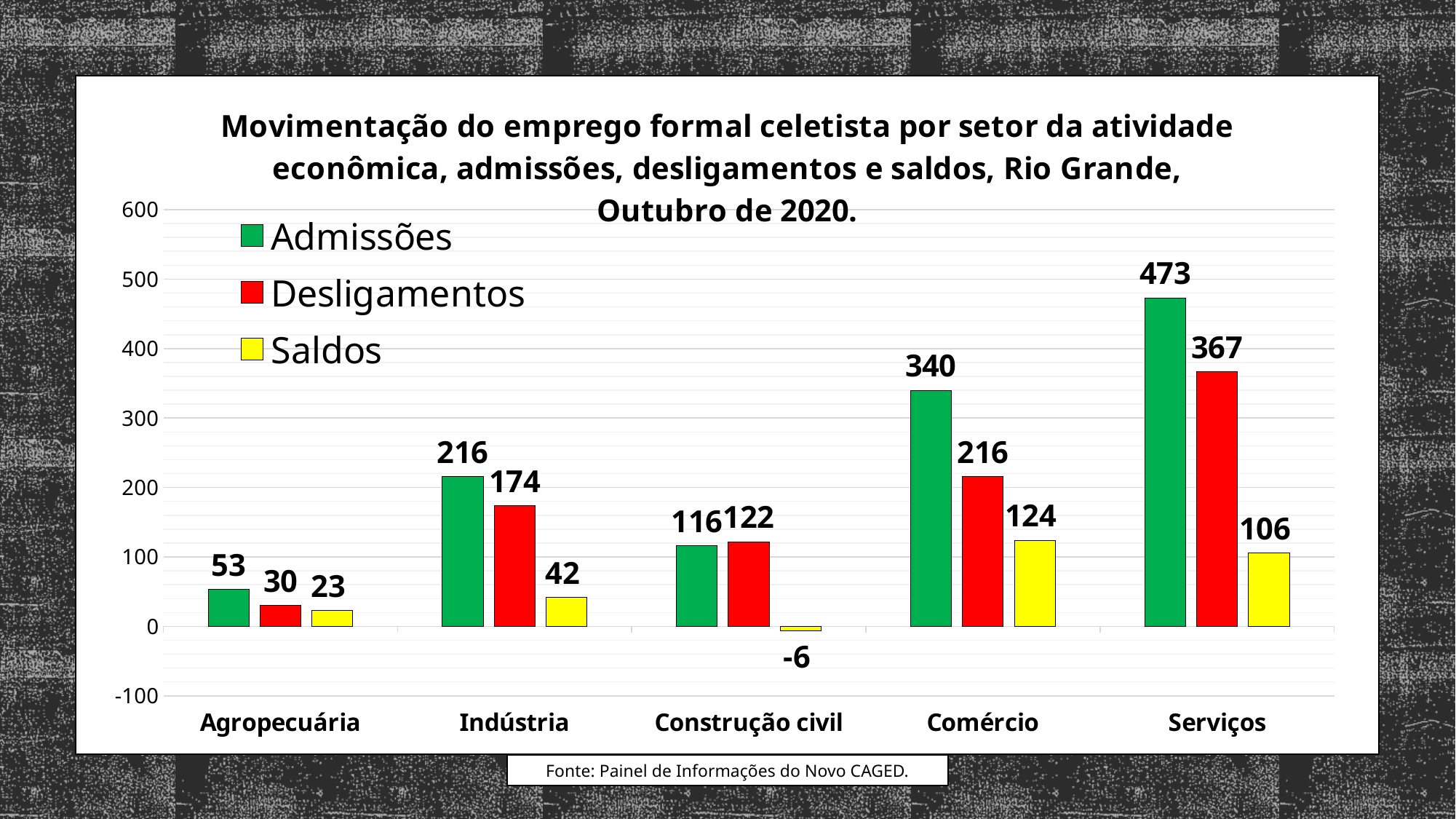
Which colour represents Saldos in the chart? Yellow Which sector has the highest Admissões value? Serviços Which is larger for Construção civil, Admissões or Desligamentos? Desligamentos What kind of chart is shown on the slide? Bar chart Which sector has the lowest Desligamentos value? Agropecuária What is the difference between Admissões and Desligamentos for Comércio? 124 What is the Saldos value for Construção civil? -6 What is the Admissões value for Serviços? 473 What is the source cited below the chart? Painel de Informações do Novo CAGED How many sectors are shown on the x axis? 5 How many series does the legend list? 3 What is the Desligamentos value for Indústria? 174